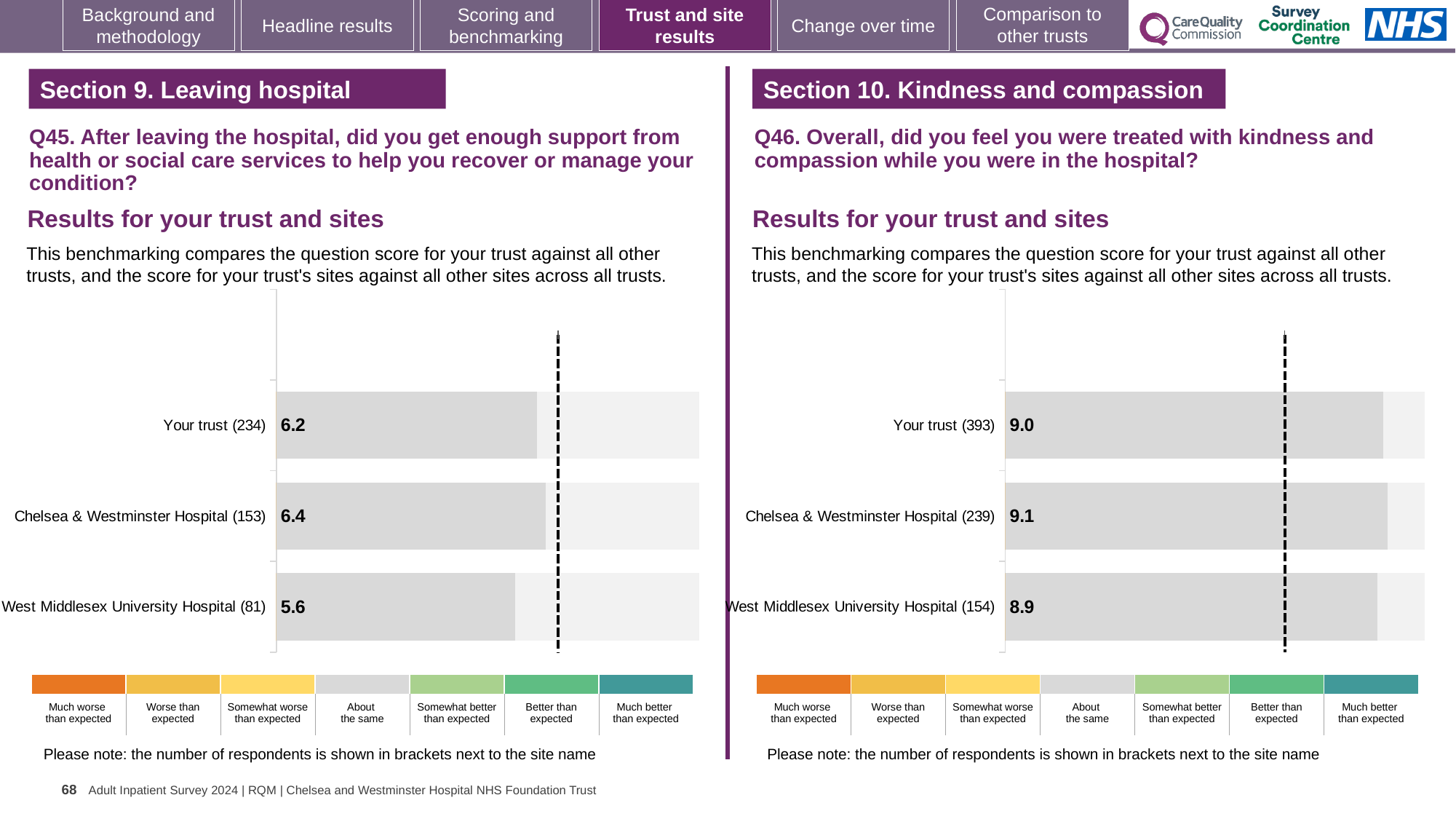
In the Q45 chart (left), which category has the highest score? Chelsea & Westminster Hospital In the Q46 chart (right), which category has the lowest score? West Middlesex University Hospital In the Q45 chart (left), what is the difference between the scores for Chelsea & Westminster Hospital and West Middlesex University Hospital? 0.8 In the Q46 chart (right), what is the difference between the scores for Chelsea & Westminster Hospital and West Middlesex University Hospital? 0.2 In the Q46 chart (right), what is the score for Chelsea & Westminster Hospital? 9.1 In the Q45 chart (left), what is the score for West Middlesex University Hospital? 5.6 How many categories (bars) are shown in the Q46 chart (right)? 3 In the Q46 chart (right), what is the score for Your trust? 9.0 What kind of chart is used for the Q45 results (left)? Bar chart In the Q45 chart (left), how many respondents are shown in brackets for West Middlesex University Hospital? 81 In the Q45 chart (left), which has a higher score: Your trust or West Middlesex University Hospital? Your trust In the Q45 chart (left), what is the score for Your trust? 6.2